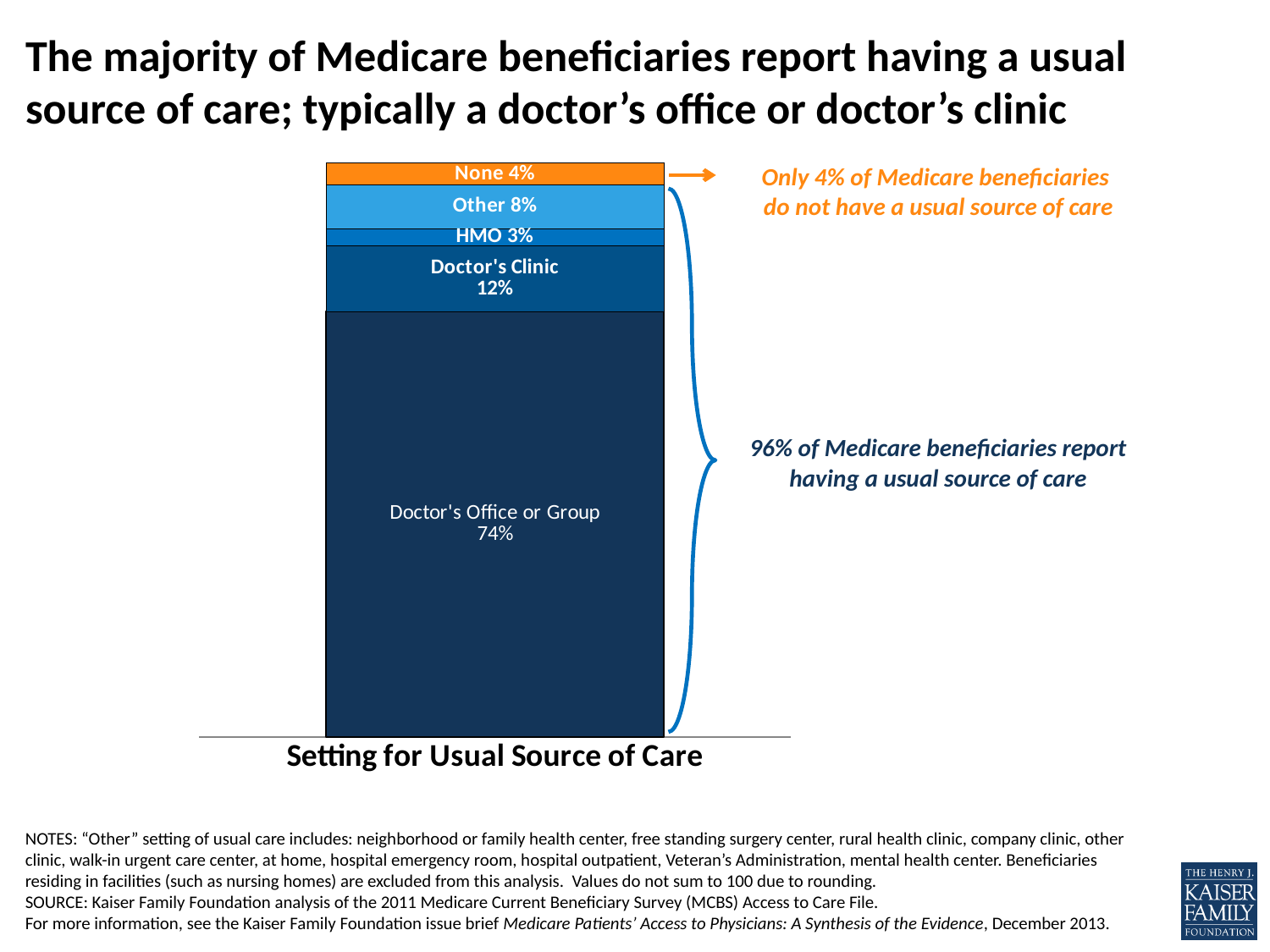
What is the label printed beneath the bar on the category axis? Setting for Usual Source of Care What percentage of Medicare beneficiaries report having no usual source of care (the None segment)? 4% Which segment is larger, Other or None? Other Which setting has the smallest share of the stacked bar? HMO What percentage is shown for the HMO segment? 3% How many segments make up the stacked bar? 5 What type of chart is shown on the slide? Stacked bar chart What percentage of Medicare beneficiaries report a doctor's office or group as their usual source of care? 74% Which setting has the largest share of the stacked bar? Doctor's Office or Group What percentage is shown for the Other segment? 8% How many percentage points larger is the Doctor's Office or Group segment than the Doctor's Clinic segment? 62 percentage points What is the value shown for the Doctor's Clinic segment of the bar? 12%